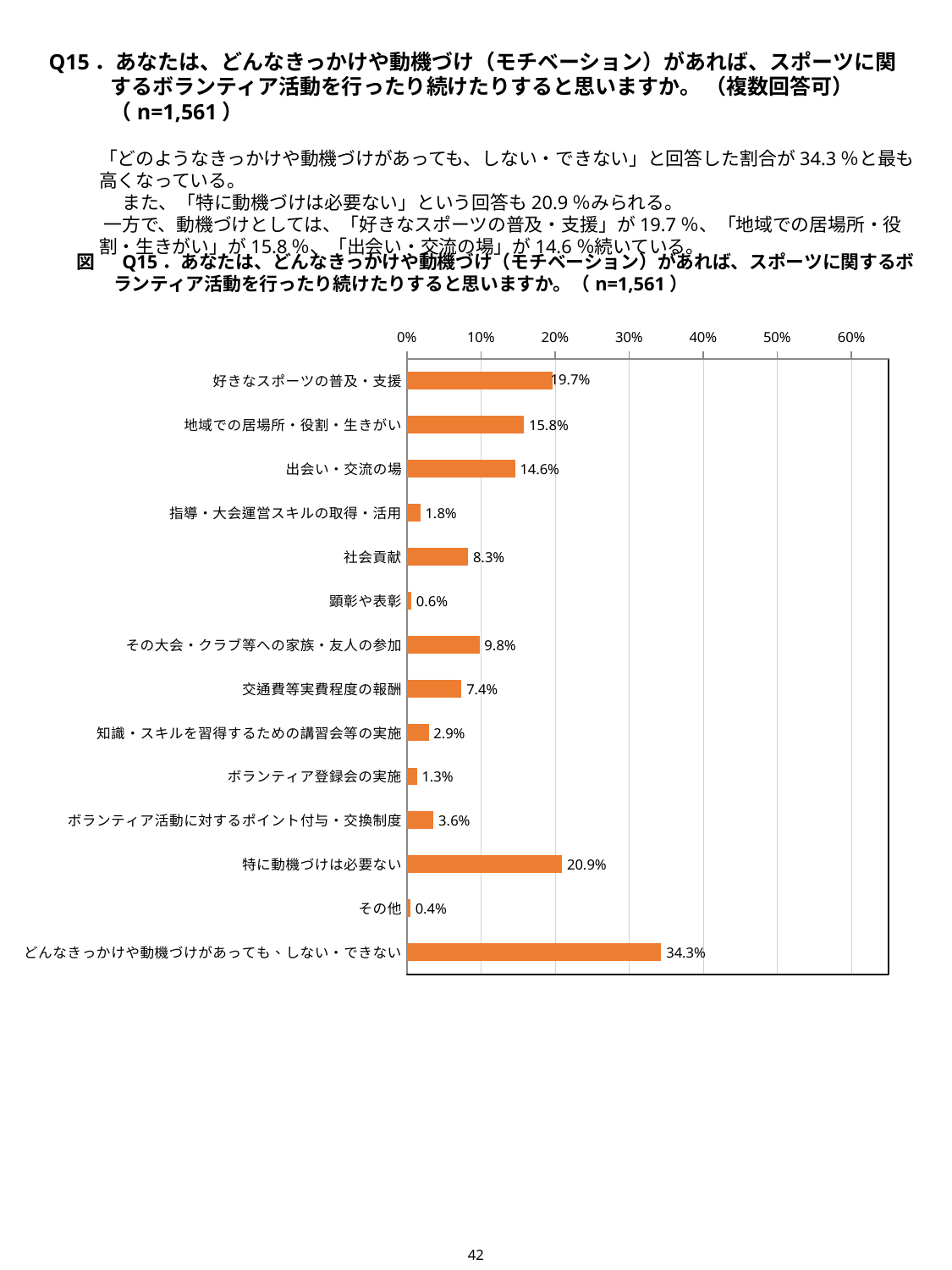
What is the difference between どんなきっかけや動機づけがあっても、しない・できない and 特に動機づけは必要ない? 13.4% What is the value for 交通費等実費程度の報酬? 7.4% What is the maximum value shown on the horizontal axis? 60% Is the value for どんなきっかけや動機づけがあっても、しない・できない greater or less than 30%? greater Which category has the highest value? どんなきっかけや動機づけがあっても、しない・できない How many categories are shown in the chart? 14 Which category has the lowest value? その他 What is the value for 特に動機づけは必要ない? 20.9% What kind of chart is shown? bar chart What is the value for 好きなスポーツの普及・支援? 19.7% Which is larger, 社会貢献 or その大会・クラブ等への家族・友人の参加? その大会・クラブ等への家族・友人の参加 What is the difference between 好きなスポーツの普及・支援 and 出会い・交流の場? 5.1%